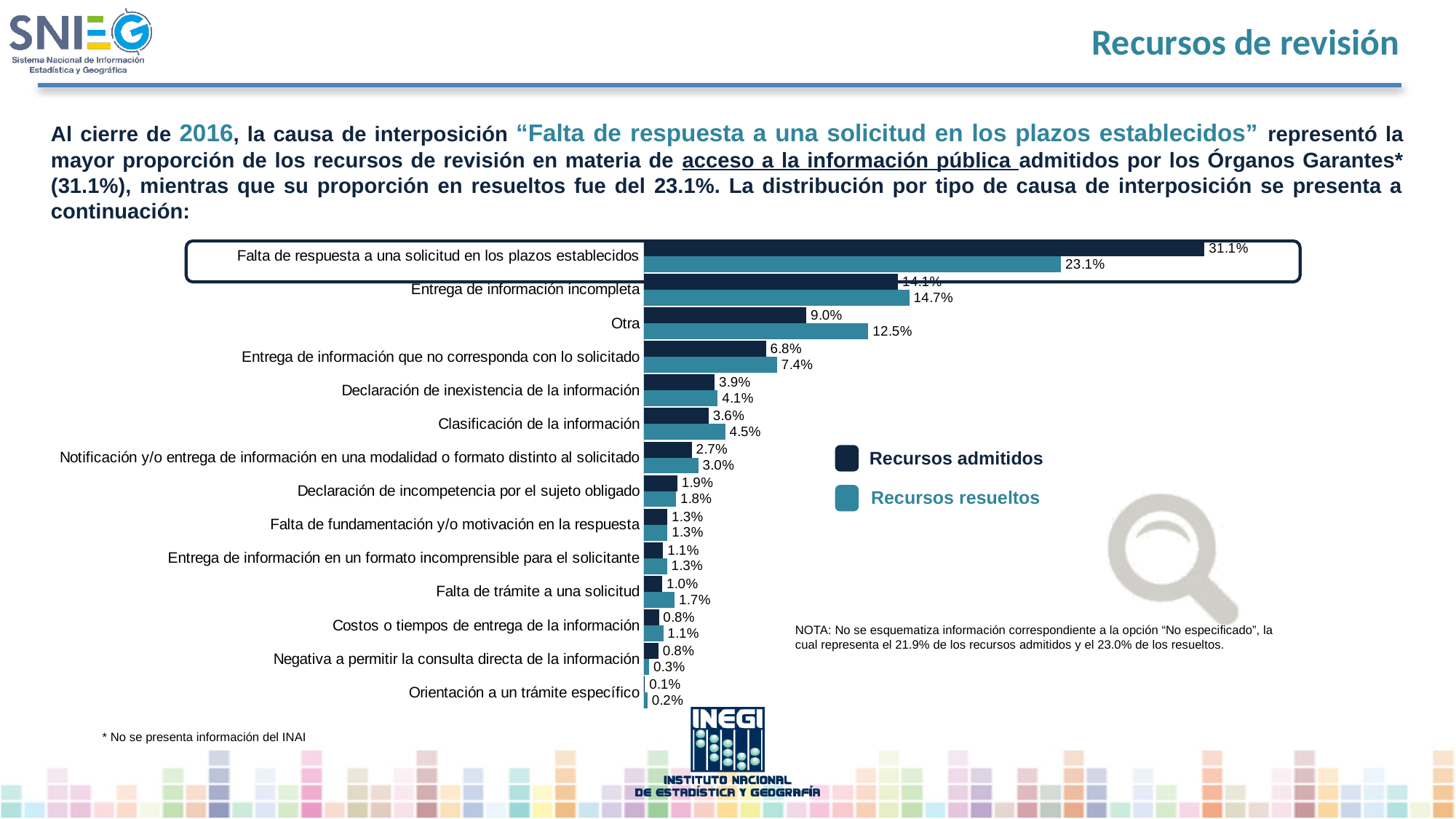
What is the value of Recursos admitidos for 'Clasificación de la información'? 3.6% Which category has the highest value for Recursos admitidos? Falta de respuesta a una solicitud en los plazos establecidos What is the value of Recursos admitidos for 'Falta de respuesta a una solicitud en los plazos establecidos'? 31.1% How many series does the legend list? 2 Which category has the lowest value for Recursos resueltos? Orientación a un trámite específico For 'Otra', which is larger: Recursos admitidos or Recursos resueltos? Recursos resueltos How many categories (causes) are plotted in the chart? 14 What is the value of Recursos resueltos for 'Otra'? 12.5% What is the value of Recursos resueltos for 'Entrega de información incompleta'? 14.7% Which series is shown in the dark navy colour? Recursos admitidos What type of chart is shown on the slide? bar chart What is the difference between Recursos admitidos and Recursos resueltos for 'Falta de respuesta a una solicitud en los plazos establecidos'? 8.0%